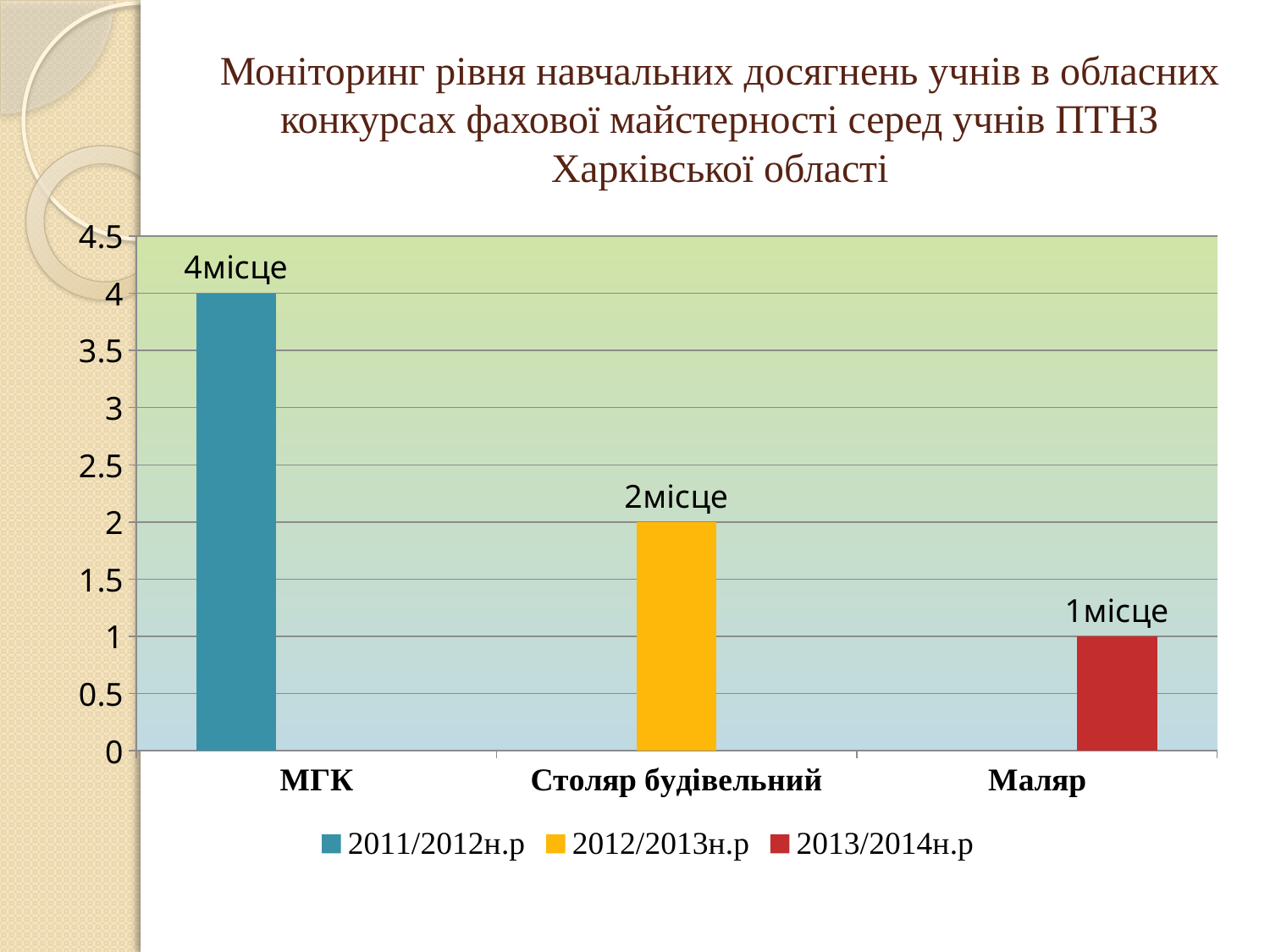
What kind of chart is shown on the slide? bar chart Which bar is taller, Столяр будівельний or Маляр? Столяр будівельний How many series does the legend list? 3 Which category has the shortest bar? Маляр Which category has the tallest bar? МГК How many categories are shown on the x axis? 3 What is the data label on the bar for МГК? 4місце What is the data label on the bar for Маляр? 1місце What is the data label on the bar for Столяр будівельний? 2місце Which legend entry corresponds to the red bar? 2013/2014н.р Do the bar values rise or fall from left to right along the x axis? fall What is the difference between the bar values for МГК and Столяр будівельний? 2